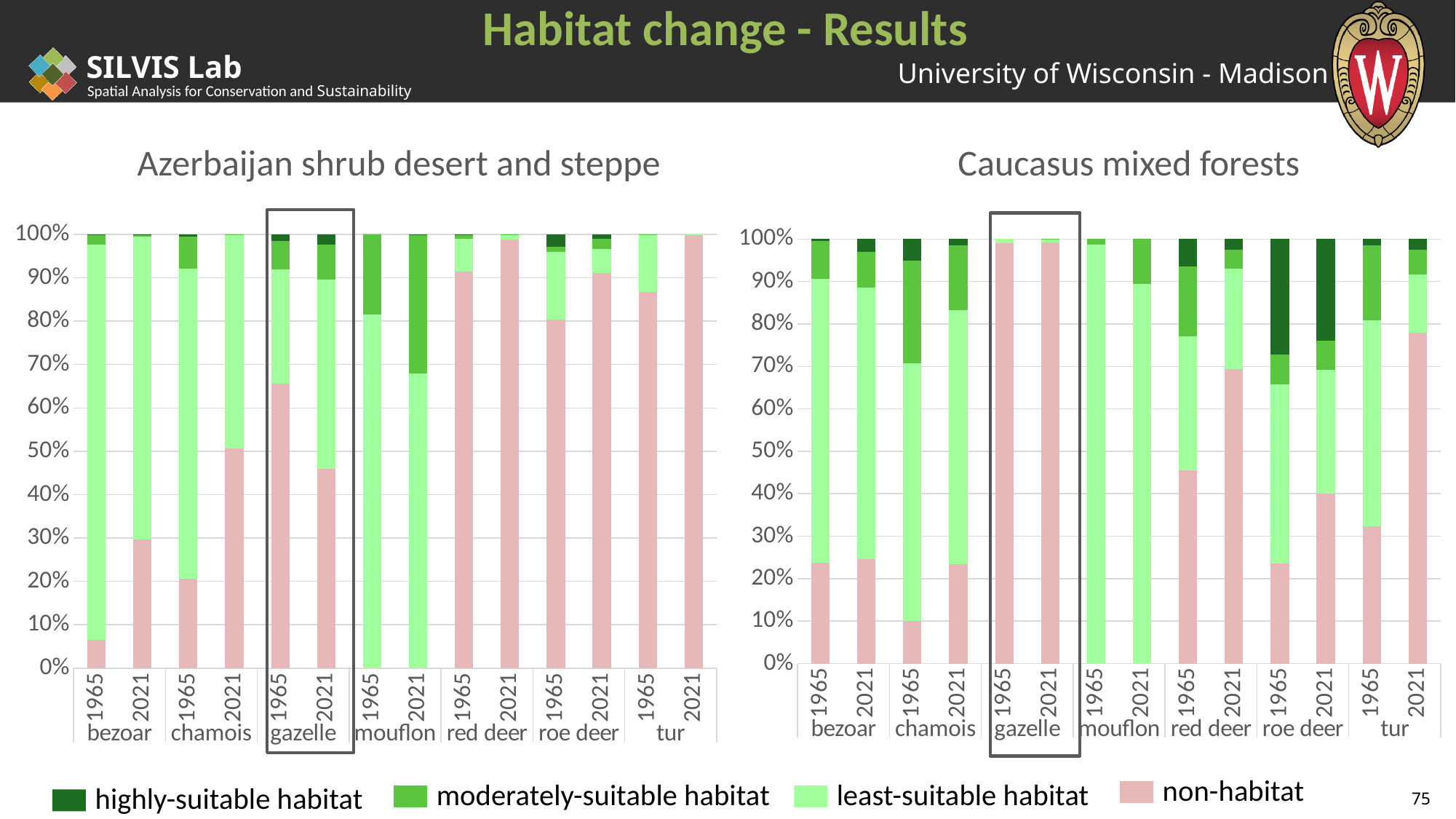
How many species are shown on the x axis of the Caucasus mixed forests chart? 7 In the Azerbaijan shrub desert and steppe chart, which year has the larger non-habitat share for chamois, 1965 or 2021? 2021 What kind of chart is used for the Azerbaijan shrub desert and steppe data? stacked bar chart In the Azerbaijan shrub desert and steppe chart, is the non-habitat share for gazelle in 1965 greater or less than 60%? greater In the Caucasus mixed forests chart, is the non-habitat share for red deer in 1965 greater or less than 50%? less In the Azerbaijan shrub desert and steppe chart, which species has no non-habitat share in either year? mouflon In the Azerbaijan shrub desert and steppe chart, is the non-habitat share for bezoar in 2021 greater or less than 20%? greater How many habitat categories does the legend list? 4 In the Caucasus mixed forests chart, which species has the largest non-habitat share in 2021? gazelle Which legend entry is shown in pink? non-habitat In the Caucasus mixed forests chart, which has the larger non-habitat share in 2021, red deer or roe deer? red deer